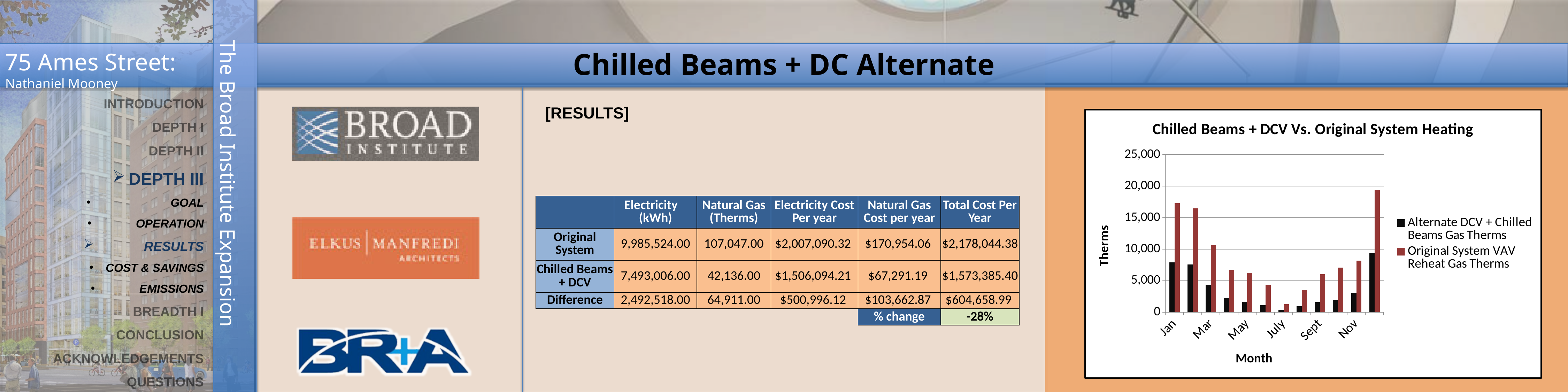
Do the Original System VAV Reheat Gas Therms values rise or fall from Jan to July? fall How many series does the legend of the chart list? 2 Is the value for Original System VAV Reheat Gas Therms in July greater or less than 5,000? less What is the title of the chart on the slide? Chilled Beams + DCV Vs. Original System Heating Is the value for Original System VAV Reheat Gas Therms in Jan greater or less than 15,000? greater Which labeled month has the lowest value for Original System VAV Reheat Gas Therms? July What is the label on the vertical axis of the chart? Therms What type of chart is shown on the slide? bar chart In Jan, which series has the higher value: Alternate DCV + Chilled Beams Gas Therms or Original System VAV Reheat Gas Therms? Original System VAV Reheat Gas Therms Is the value for Original System VAV Reheat Gas Therms in Nov greater or less than 10,000? less